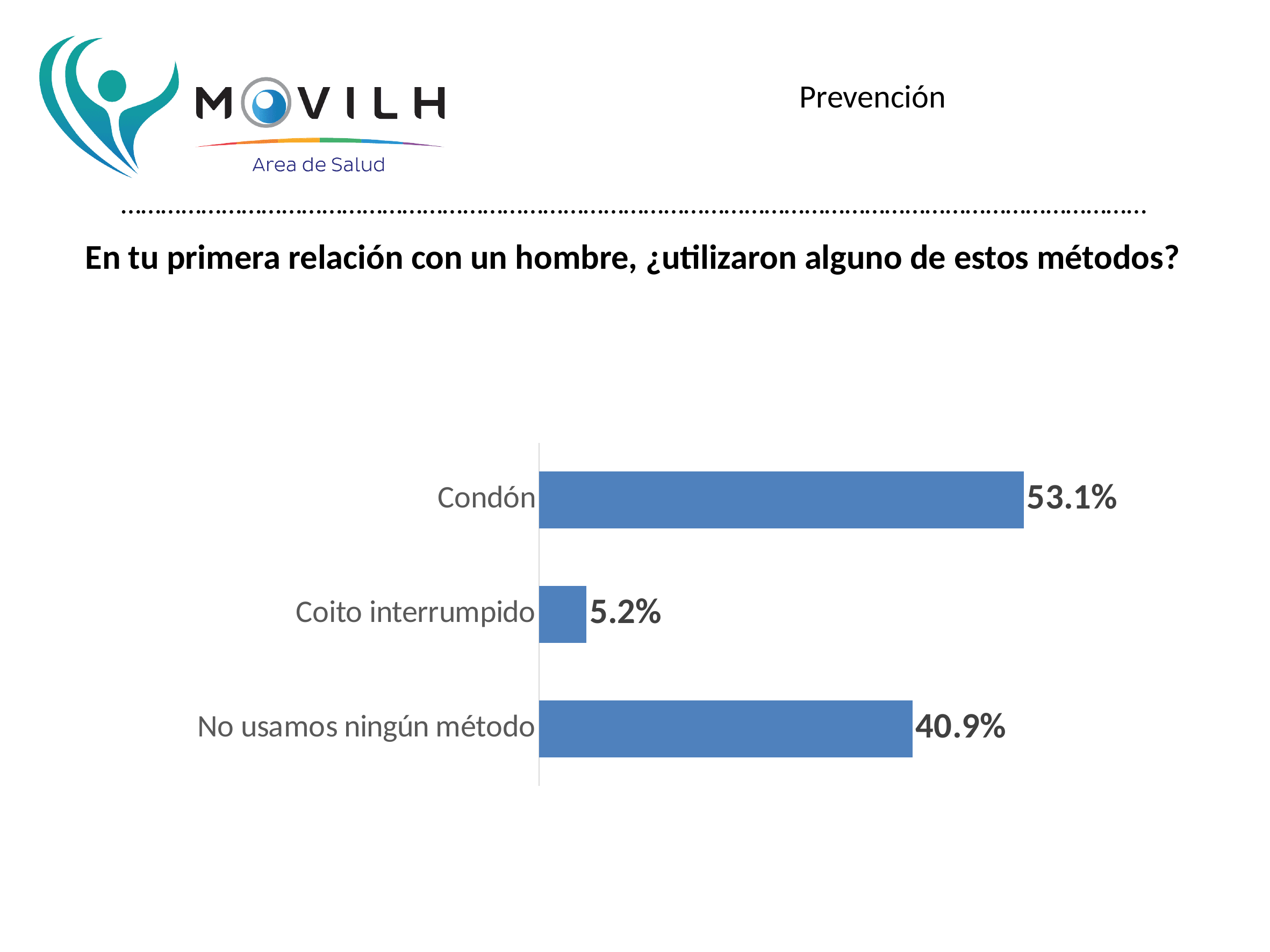
What question does the chart title ask? En tu primera relación con un hombre, ¿utilizaron alguno de estos métodos? Which is larger, the value for Condón or the value for No usamos ningún método? Condón What is the value for Coito interrumpido? 5.2% What is the difference between the values for No usamos ningún método and Coito interrumpido? 35.7% What is the value for No usamos ningún método? 40.9% What is the difference between the values for Condón and No usamos ningún método? 12.2% Which is larger, the value for Coito interrumpido or the value for No usamos ningún método? No usamos ningún método What is the value for Condón? 53.1% Which category has the highest value? Condón Which category has the lowest value? Coito interrumpido What kind of chart is shown on the slide? Bar chart How many categories are shown in the chart? 3